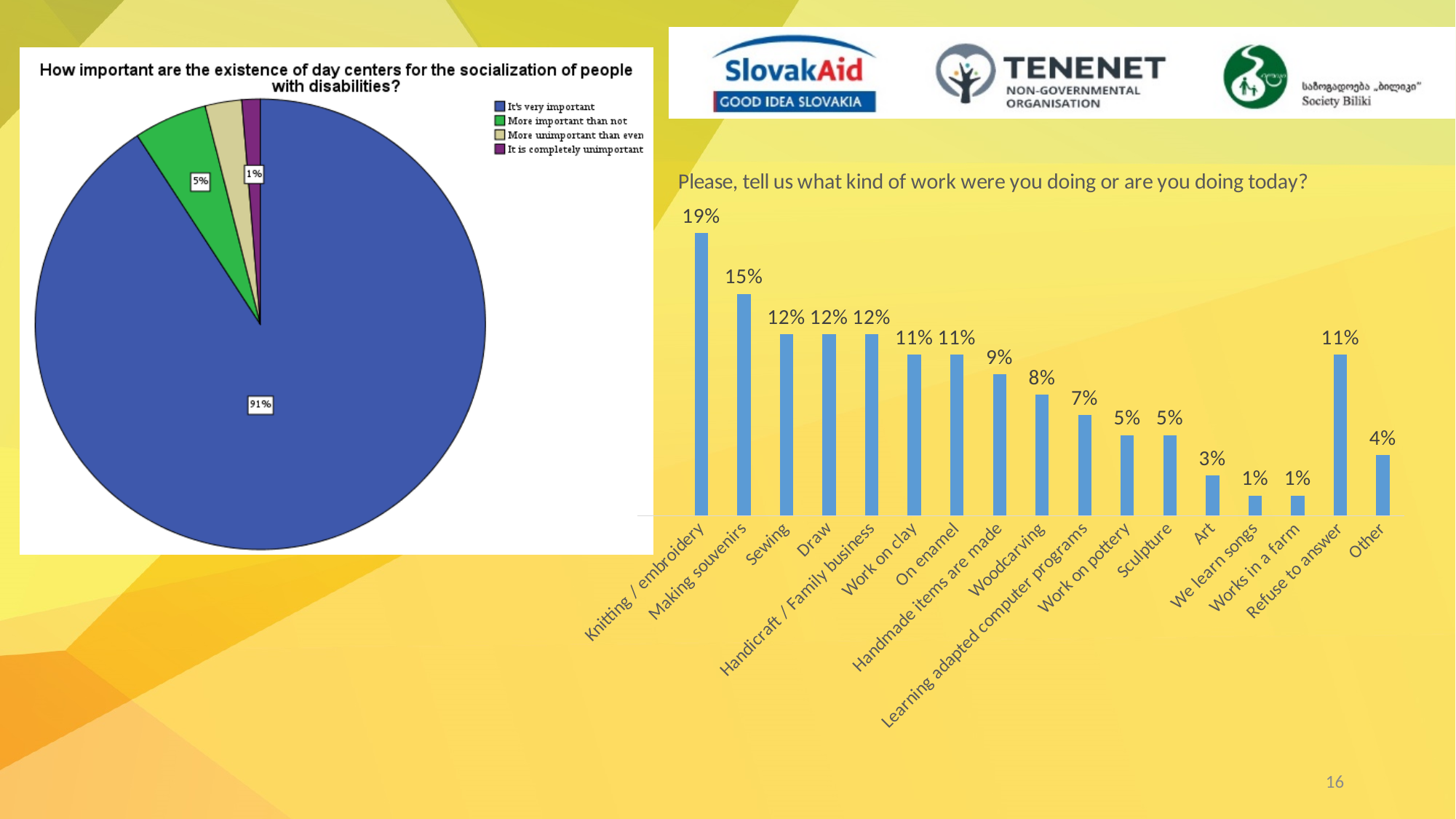
In the bar chart on the right, what is the value for Refuse to answer? 11% In the bar chart on the right, what is the value for Knitting / embroidery? 19% In the bar chart on the right, what is the difference between Making souvenirs and Sewing? 3% In the bar chart on the right, which is larger, Learning adapted computer programs or Art? Learning adapted computer programs In the bar chart on the right, what is the value for Woodcarving? 8% In the bar chart on the right, which category has the highest value? Knitting / embroidery What kind of chart is the chart on the right of the slide? Bar chart In the pie chart on the left, what share of respondents said 'It's very important'? 91% How many entries does the legend of the pie chart on the left list? 4 How many categories are shown in the bar chart on the right? 17 In the pie chart on the left, what share of respondents said 'More important than not'? 5% What kind of chart is the chart on the left of the slide? Pie chart